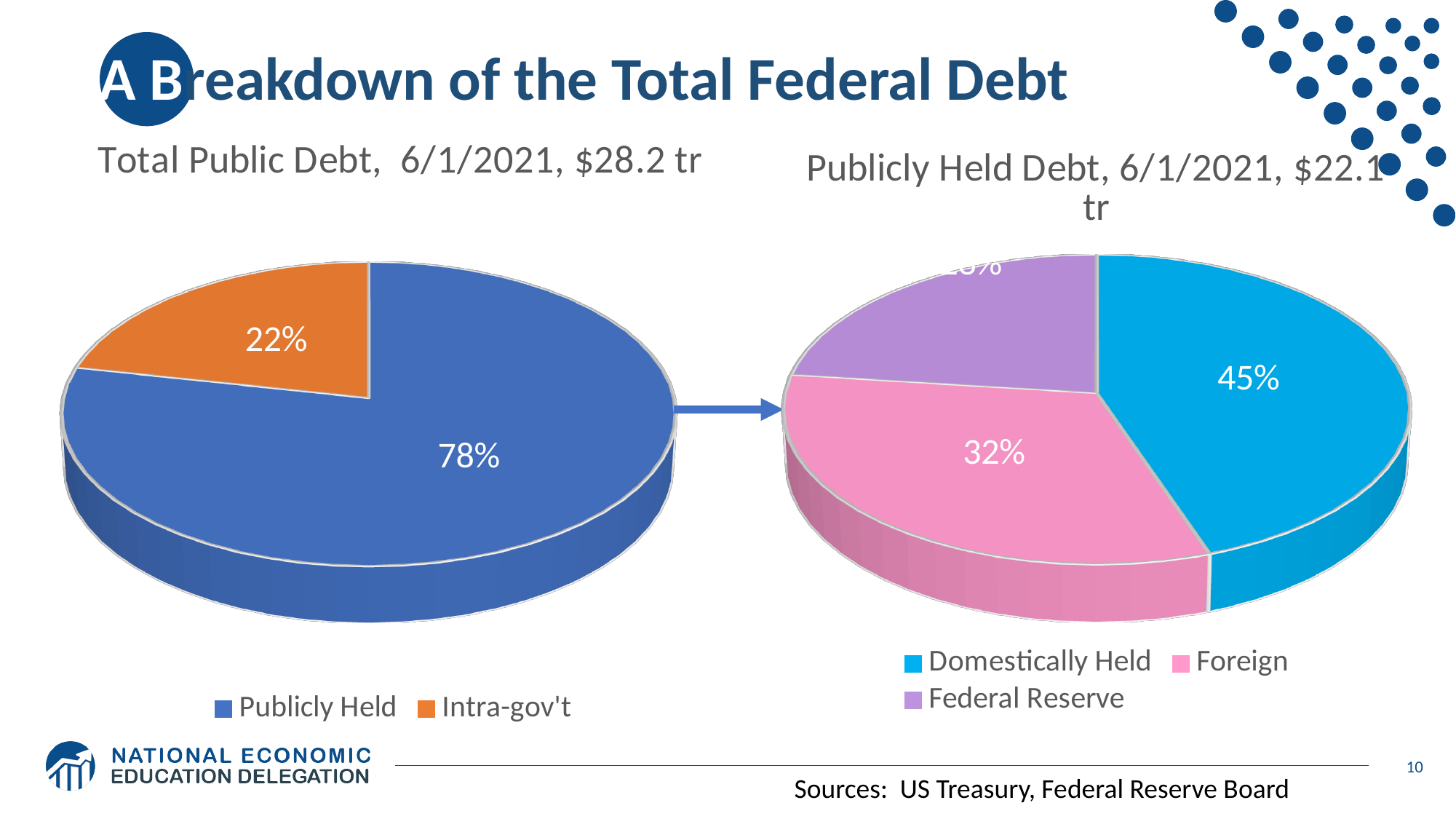
In the 'Publicly Held Debt, 6/1/2021, $22.1 tr' chart, what share is Foreign? 32% In the 'Publicly Held Debt, 6/1/2021, $22.1 tr' chart, which slice is the smallest? Federal Reserve How many slices does the 'Total Public Debt, 6/1/2021, $28.2 tr' chart have? 2 What kind of chart is the 'Total Public Debt, 6/1/2021, $28.2 tr' chart? Pie chart In the 'Total Public Debt, 6/1/2021, $28.2 tr' chart, which slice is the largest? Publicly Held In the 'Total Public Debt, 6/1/2021, $28.2 tr' chart, what share is Intra-gov't? 22% In the 'Total Public Debt, 6/1/2021, $28.2 tr' chart, what is the difference in percentage points between Publicly Held and Intra-gov't? 56 percentage points In the 'Publicly Held Debt, 6/1/2021, $22.1 tr' chart, how many categories does the legend list? 3 In the 'Publicly Held Debt, 6/1/2021, $22.1 tr' chart, which slice is the largest? Domestically Held In the 'Total Public Debt, 6/1/2021, $28.2 tr' chart, what share is Publicly Held? 78% In the 'Publicly Held Debt, 6/1/2021, $22.1 tr' chart, what share is Domestically Held? 45% In the 'Publicly Held Debt, 6/1/2021, $22.1 tr' chart, what colour is the Foreign slice? Pink